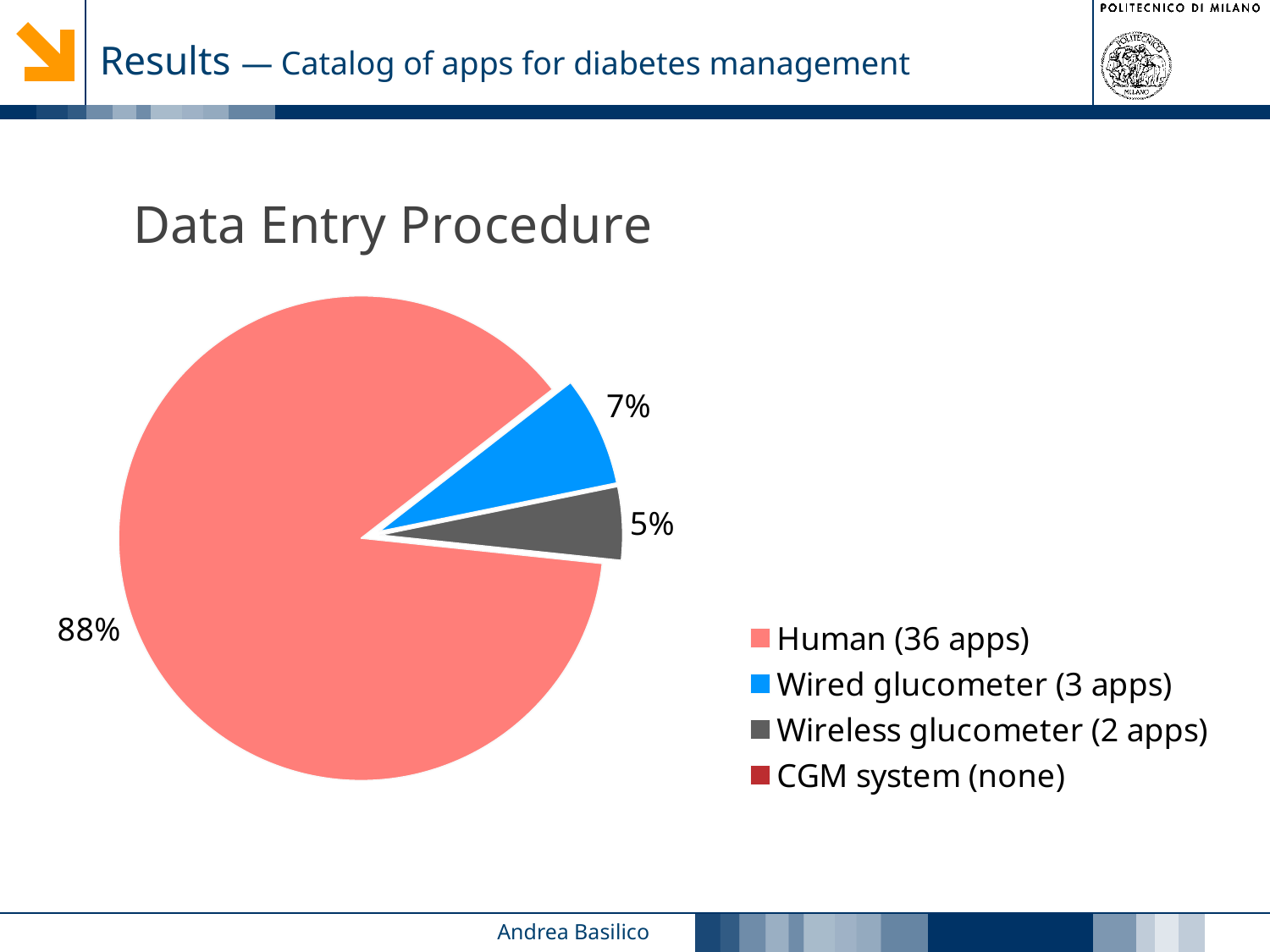
What is the difference in percentage points between the Human slice and the Wired glucometer slice? 81 How many apps are listed for the CGM system category in the legend? none What percentage of the pie does the Wireless glucometer slice represent? 5% Which category has the largest share of the pie? Human (36 apps) How many apps are listed for the Wireless glucometer category in the legend? 2 apps What colour is the Human slice of the pie? red (salmon) What is the title of the chart? Data Entry Procedure What percentage of the pie does the Wired glucometer slice represent? 7% How many entries does the legend list? 4 What percentage of the pie does the Human slice represent? 88% What type of chart is shown on the slide? pie chart Which is larger, the Wired glucometer slice or the Wireless glucometer slice? Wired glucometer